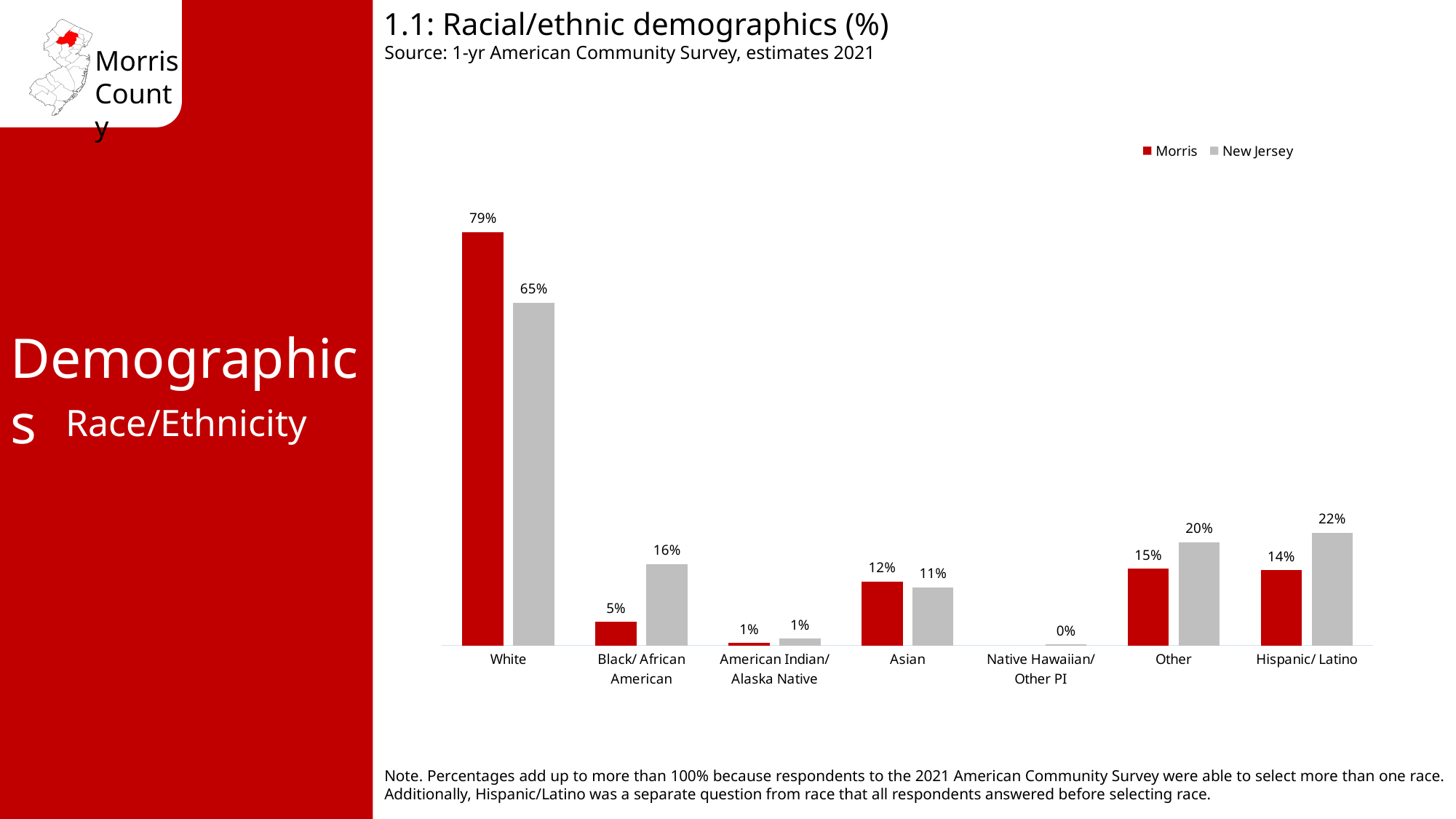
What is the Morris value for Black/ African American? 5% Which is larger for Hispanic/ Latino, the Morris value or the New Jersey value? New Jersey How many series does the legend list? 2 What kind of chart is shown on the slide? Bar chart What is the Morris value for White? 79% What is the New Jersey value for Hispanic/ Latino? 22% What is the difference between the Morris and New Jersey values for White? 14% What is the difference between the New Jersey and Morris values for Black/ African American? 11% Which category has the lowest New Jersey value? Native Hawaiian/ Other PI Which category has the highest Morris value? White How many racial/ethnic categories are shown on the x axis? 7 What is the New Jersey value for Other? 20%